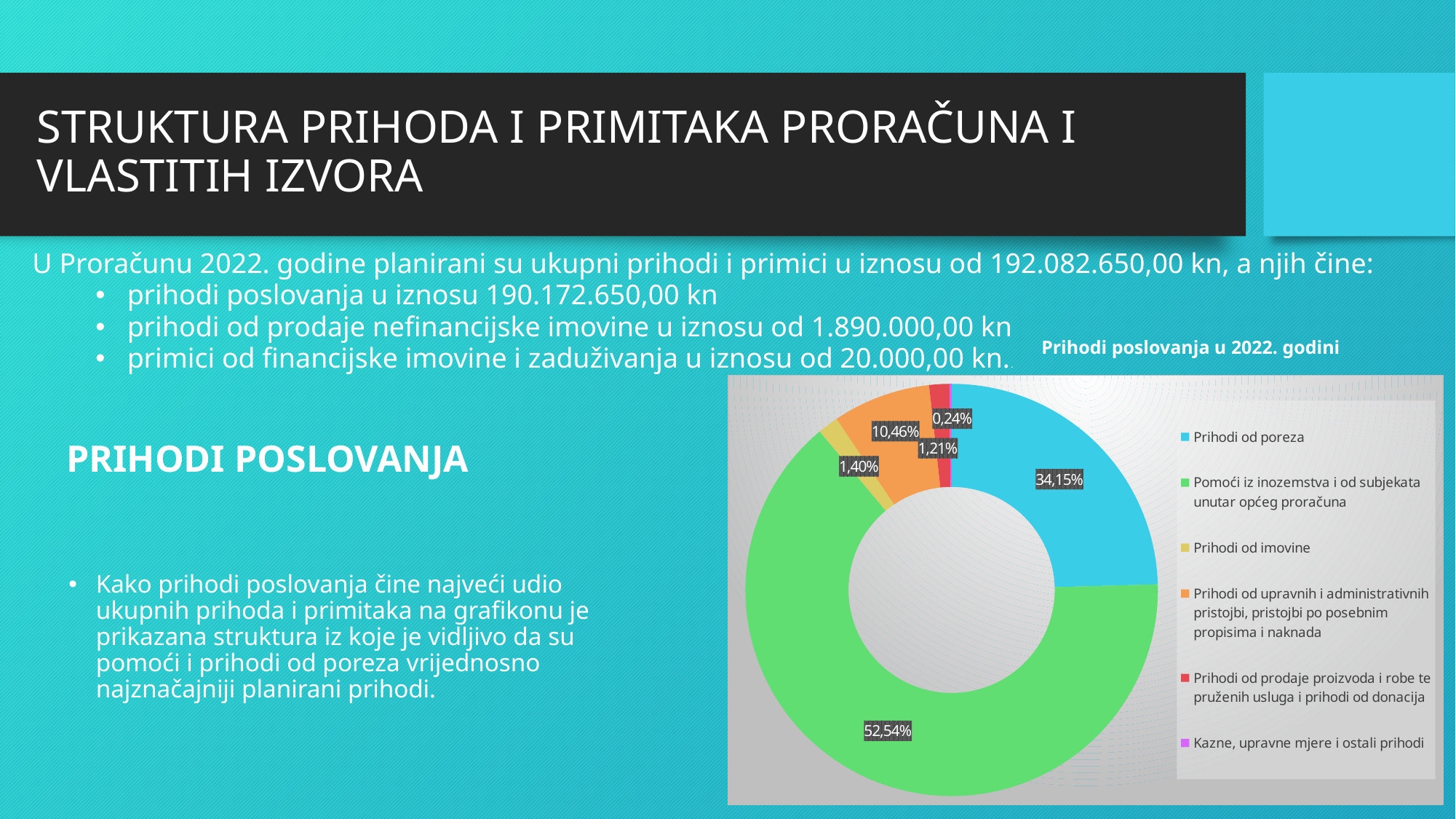
Which is larger: the share of 'Prihodi od poreza' or the share of 'Prihodi od upravnih i administrativnih pristojbi, pristojbi po posebnim propisima i naknada'? Prihodi od poreza What colour is the slice for 'Prihodi od poreza'? blue What share of the chart is 'Pomoći iz inozemstva i od subjekata unutar općeg proračuna'? 52,54% Which category has the smallest share in the chart? Kazne, upravne mjere i ostali prihodi What share of the chart is 'Prihodi od poreza'? 34,15% What share of the chart is 'Kazne, upravne mjere i ostali prihodi'? 0,24% What share of the chart is 'Prihodi od imovine'? 1,40% What kind of chart is shown on the slide? doughnut chart How many categories does the chart's legend list? 6 What is the title of the chart? Prihodi poslovanja u 2022. godini What share of the chart is 'Prihodi od upravnih i administrativnih pristojbi, pristojbi po posebnim propisima i naknada'? 10,46% Which category has the largest share in the chart? Pomoći iz inozemstva i od subjekata unutar općeg proračuna